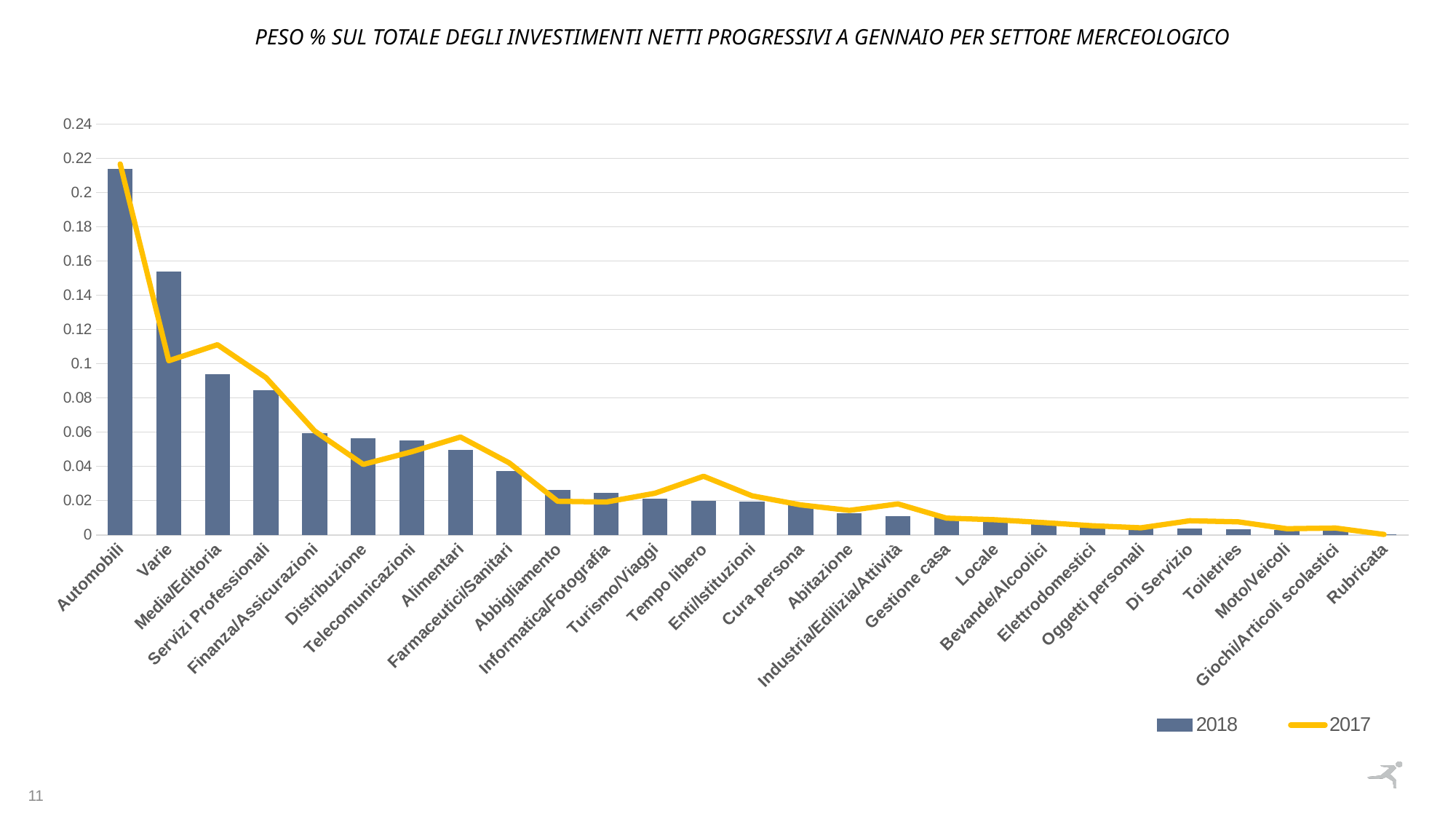
Do the 2018 bar values generally rise or fall moving from left to right along the x axis? fall For Tempo libero, which series has the larger value, 2018 or 2017? 2017 Which series is drawn as a line rather than bars? 2017 Which sector has the highest 2018 value? Automobili For Varie, which series has the larger value, 2018 or 2017? 2018 How many series does the legend list? 2 Is the 2018 value for Media/Editoria greater or less than 0.1? less What kind of chart is shown on the slide? A combined bar and line chart Which sector has the lowest 2018 value? Rubricata Is the 2018 value for Automobili greater or less than 0.2? greater Is the 2018 value for Varie greater or less than 0.14? greater How many sectors (categories) are shown on the x axis? 27